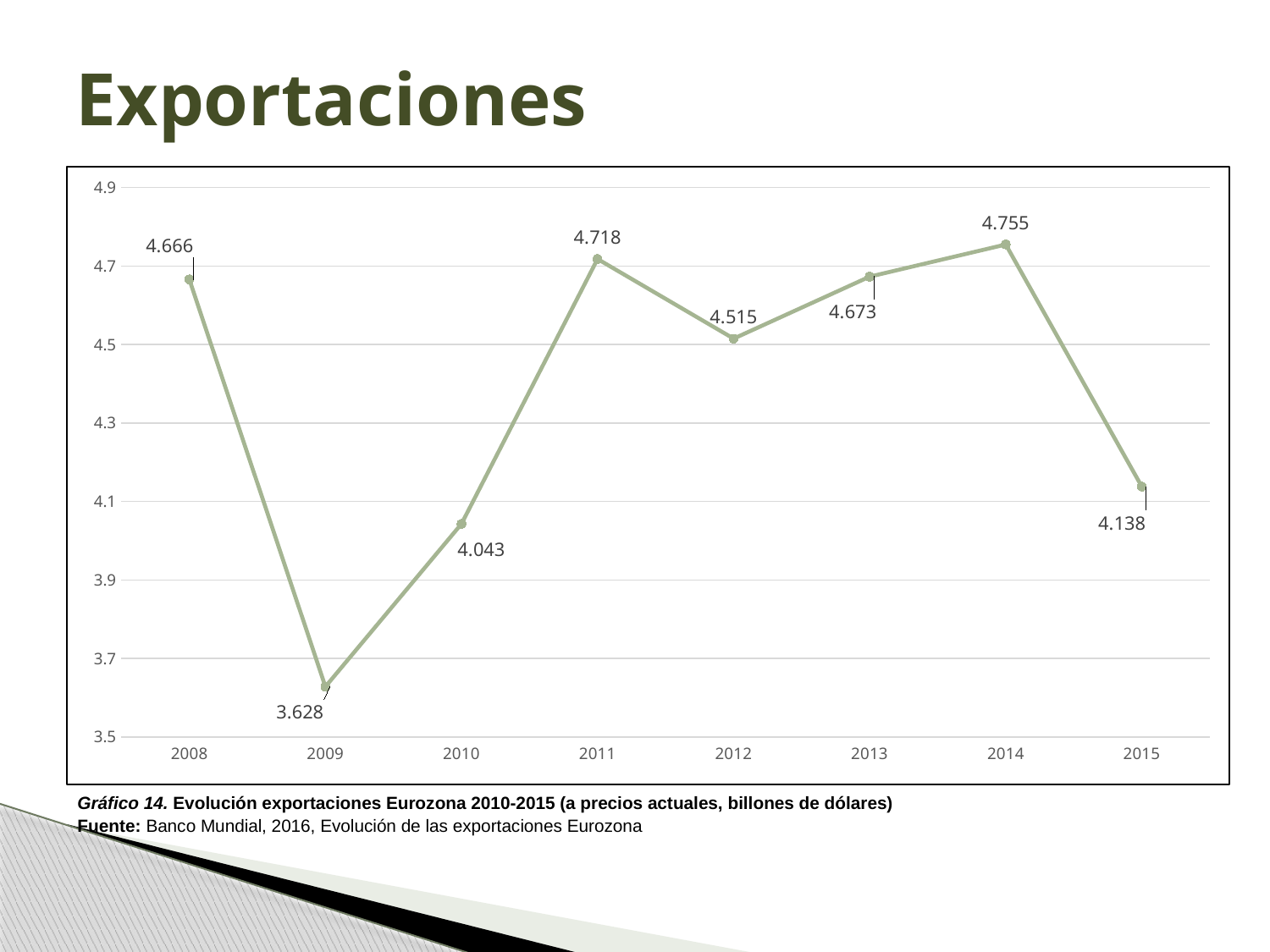
What is the value for 2009? 3.628 Which year has the lowest value? 2009 How many years are plotted on the chart? 8 What kind of chart is shown on the slide? line chart Which year has the highest value? 2014 Which is larger, the value for 2011 or the value for 2012? 2011 Do the values rise or fall from 2012 to 2014? rise What is the difference between the values for 2008 and 2009? 1.038 Is the value for 2010 greater or less than 4.1? less What is the value for 2014? 4.755 What is the difference between the values for 2014 and 2015? 0.617 What is the value for 2012? 4.515